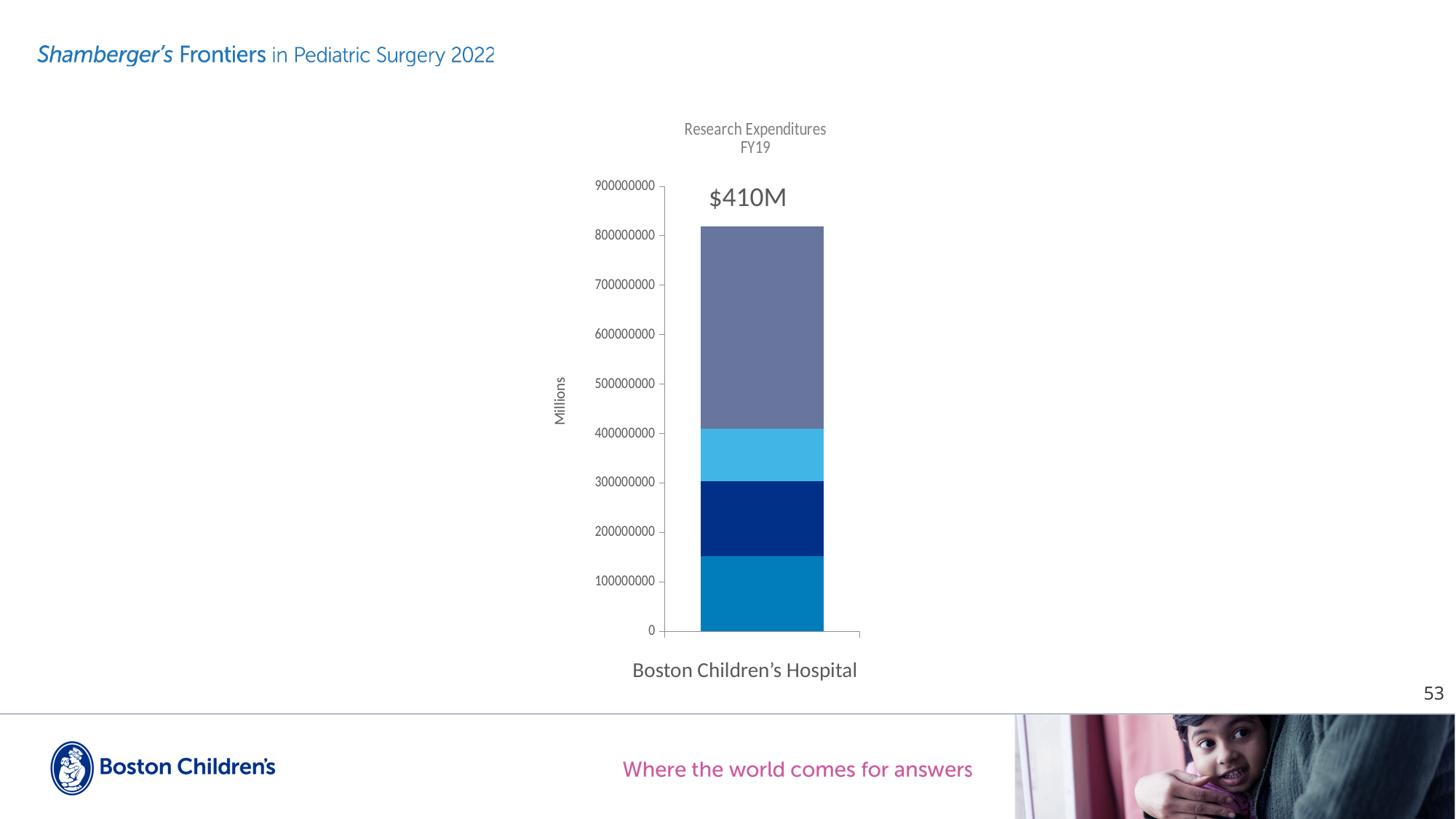
Is the top of the dark navy segment of the bar greater or less than 400000000 on the y axis? less What is the highest tick value shown on the y axis of the chart? 900000000 What kind of chart is shown on the slide? Stacked bar chart What is the name of the single category shown on the x axis? Boston Children's Hospital Is the top of the bottom (lightest blue) segment of the bar greater or less than 100000000 on the y axis? greater What is the title of the chart? Research Expenditures FY19 Is the total height of the bar for Boston Children's Hospital greater or less than 900000000 on the y axis? less What value label is printed above the bar for Boston Children's Hospital? $410M How many stacked segments make up the bar for Boston Children's Hospital? 4 How many categories are plotted on the x axis of the chart? 1